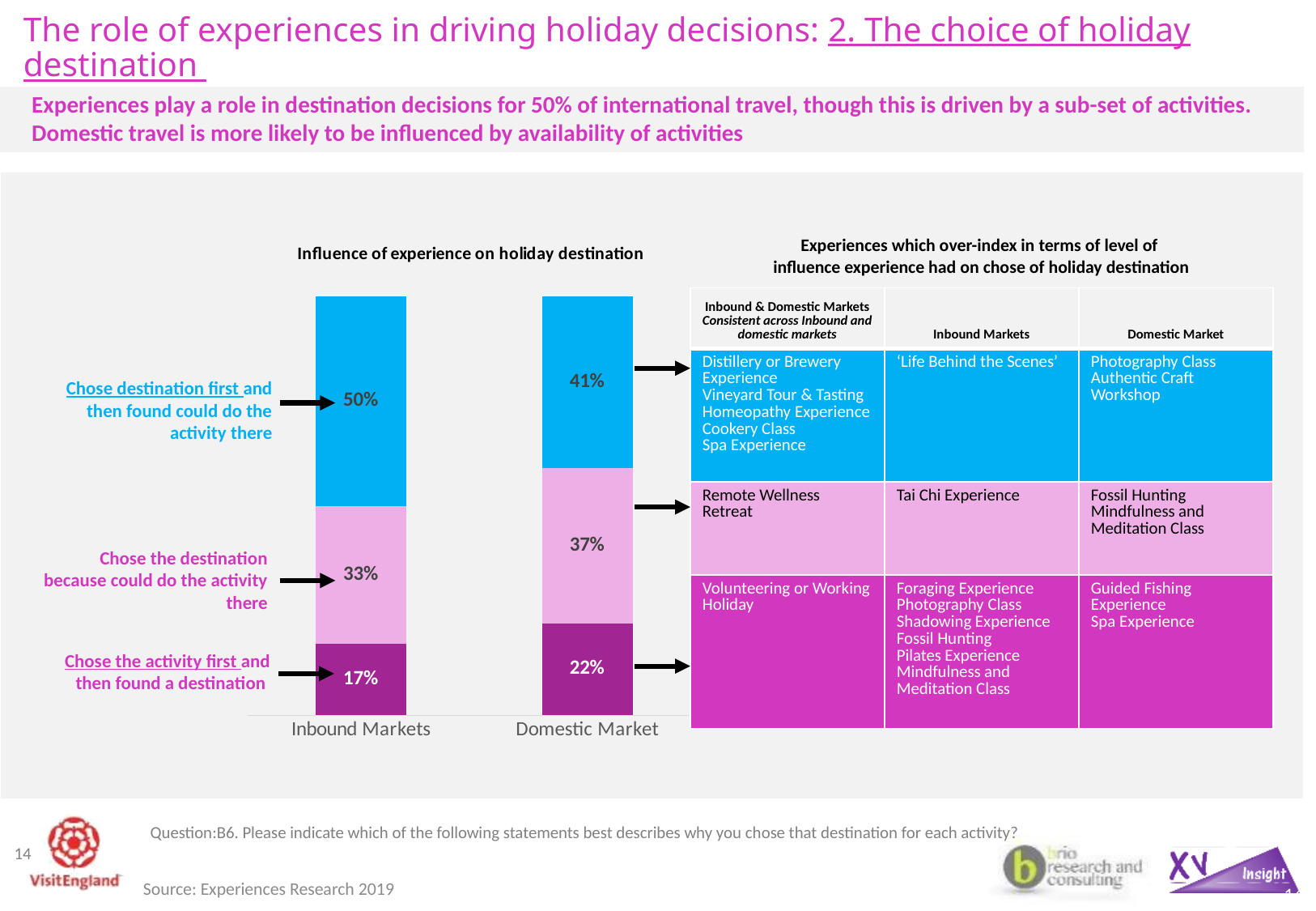
How many segments (series) make up each bar in the chart? 3 Which segment is the largest in the Inbound Markets bar? Chose destination first and then found could do the activity there Which market has the higher share for 'Chose destination first and then found could do the activity there'? Inbound Markets What is the difference between Inbound Markets and Domestic Market for 'Chose the activity first and then found a destination'? 5% What percentage of the Domestic Market chose the activity first and then found a destination? 22% What kind of chart is shown on the slide? Stacked bar chart What percentage of the Domestic Market chose the destination because they could do the activity there? 37% What percentage of Inbound Markets chose the destination first and then found they could do the activity there? 50% What is the title of the chart on the slide? Influence of experience on holiday destination What is the total of the three segments in the Domestic Market bar? 100% How many categories are shown on the x axis of the chart? 2 What percentage of Inbound Markets chose the activity first and then found a destination? 17%